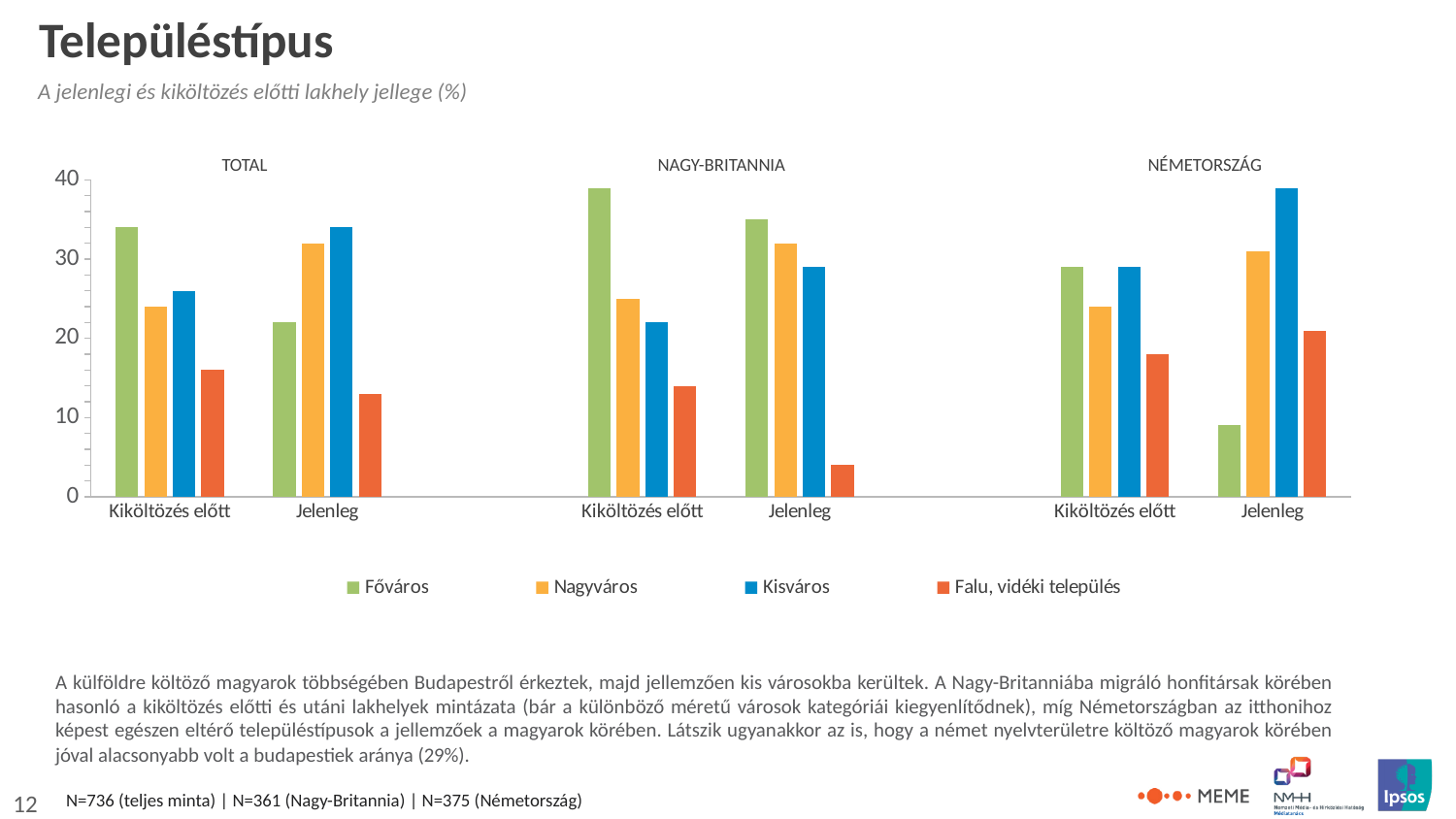
In the TOTAL panel, is the Főváros value for Kiköltözés előtt greater or less than 30? greater In the NÉMETORSZÁG panel, is the Kisváros value for Jelenleg greater or less than 30? greater What kind of chart is shown on the slide? bar chart How many panels (groups) does the chart have? 3 In the TOTAL panel, which is larger for Jelenleg: Kisváros or Főváros? Kisváros In the NÉMETORSZÁG panel, does the Főváros value rise or fall from Kiköltözés előtt to Jelenleg? fall Which series are listed in the legend? Főváros, Nagyváros, Kisváros, Falu, vidéki település In the NÉMETORSZÁG panel, which series has the lowest value for Jelenleg? Főváros In the NÉMETORSZÁG panel, which series has the highest value for Jelenleg? Kisváros In the NAGY-BRITANNIA panel, which series has the highest value for Kiköltözés előtt? Főváros How many series does the legend list? 4 In the NAGY-BRITANNIA panel, is the Falu, vidéki település value for Jelenleg greater or less than 10? less